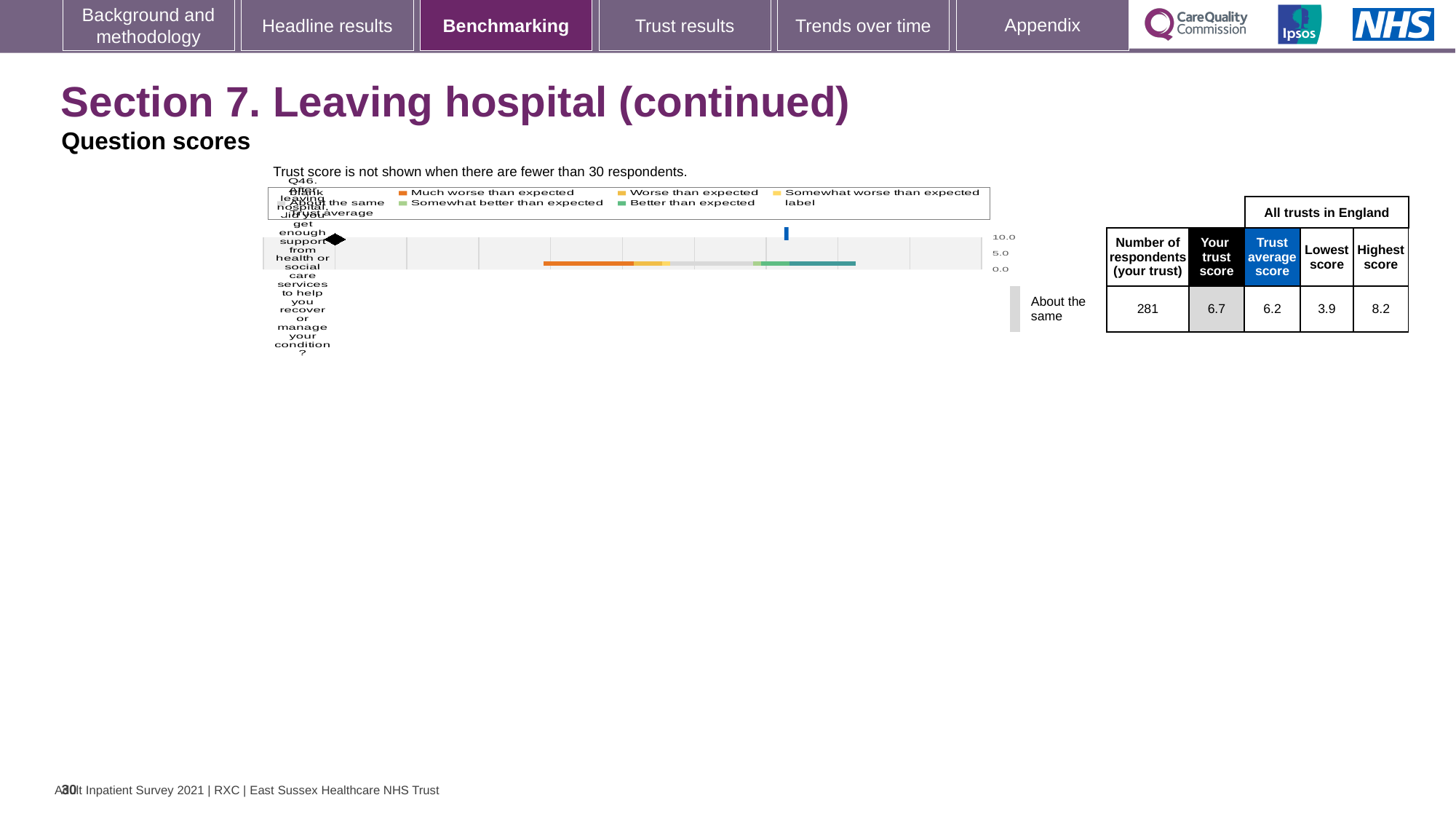
How many questions (categories) are plotted in the chart? 1 Which question number is plotted in the chart? Q46 Which colour represents 'Much worse than expected' in the chart legend? orange In the table next to the chart, which is larger: your trust score or the trust average score? Your trust score In the table next to the chart, what is the number of respondents for your trust? 281 According to the label beside the chart, how is the trust's result for Q46 categorised? About the same In the table next to the chart, what is the lowest score among all trusts in England? 3.9 What is the highest tick value shown on the chart's axis? 10.0 What kind of chart is shown on the slide? bar chart In the table next to the chart, what is the trust average score for Q46? 6.2 In the table next to the chart, what is your trust score for Q46? 6.7 In the table next to the chart, what is the highest score among all trusts in England? 8.2